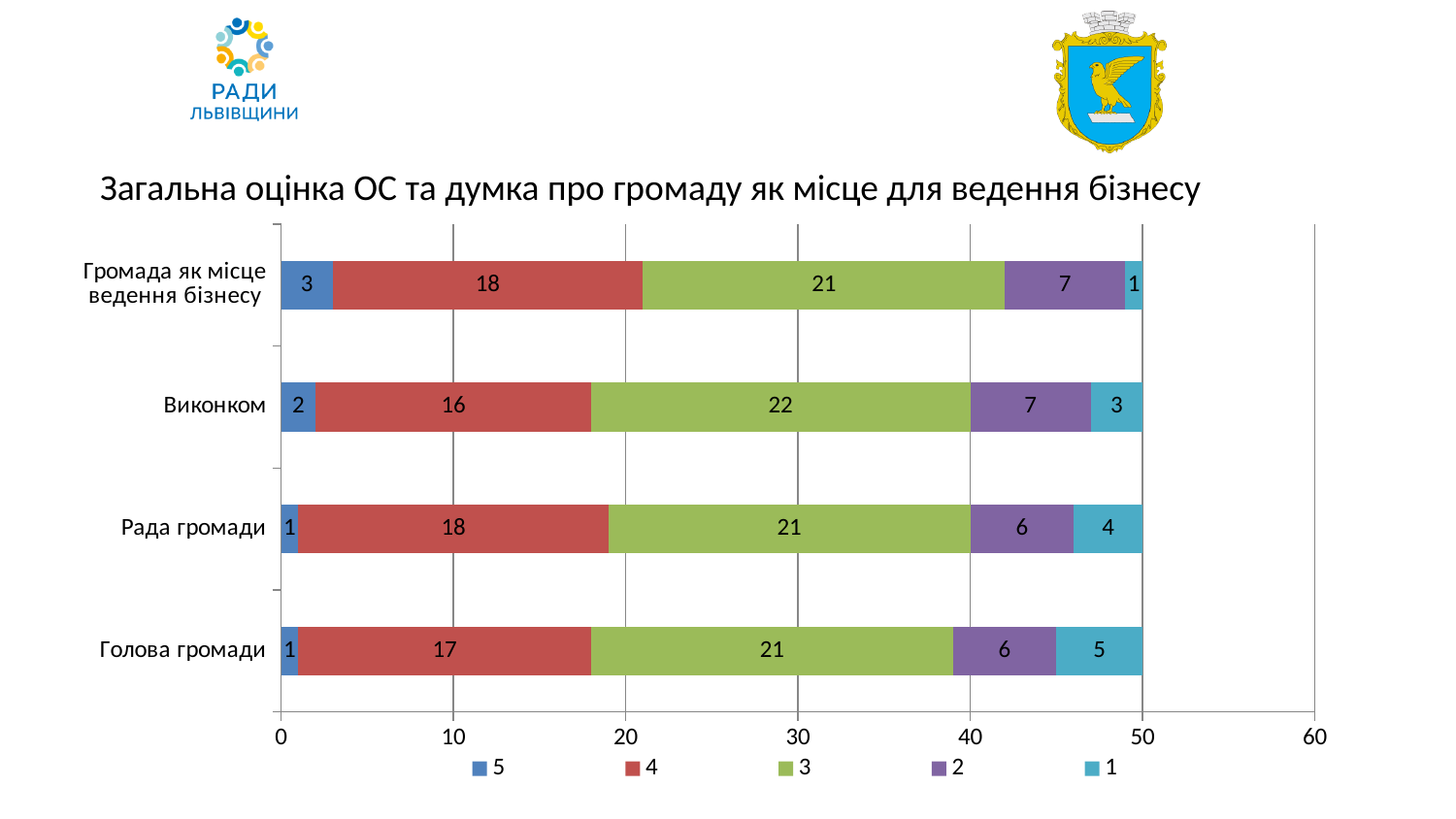
How many categories are shown on the chart? 4 What is the value of series "1" for "Громада як місце ведення бізнесу"? 1 What is the value of series "4" for "Голова громади"? 17 What kind of chart is shown on the slide? Stacked bar chart What is the value of series "3" for "Виконком"? 22 How many series does the legend list? 5 What is the total of the stacked bar for "Виконком"? 50 What is the difference between the series "4" values for "Рада громади" and "Виконком"? 2 What is the value of series "2" for "Рада громади"? 6 Which is larger: the series "1" value for "Голова громади" or for "Виконком"? Голова громади Which category has the highest value for series "5"? Громада як місце ведення бізнесу Which category has the lowest value for series "1"? Громада як місце ведення бізнесу